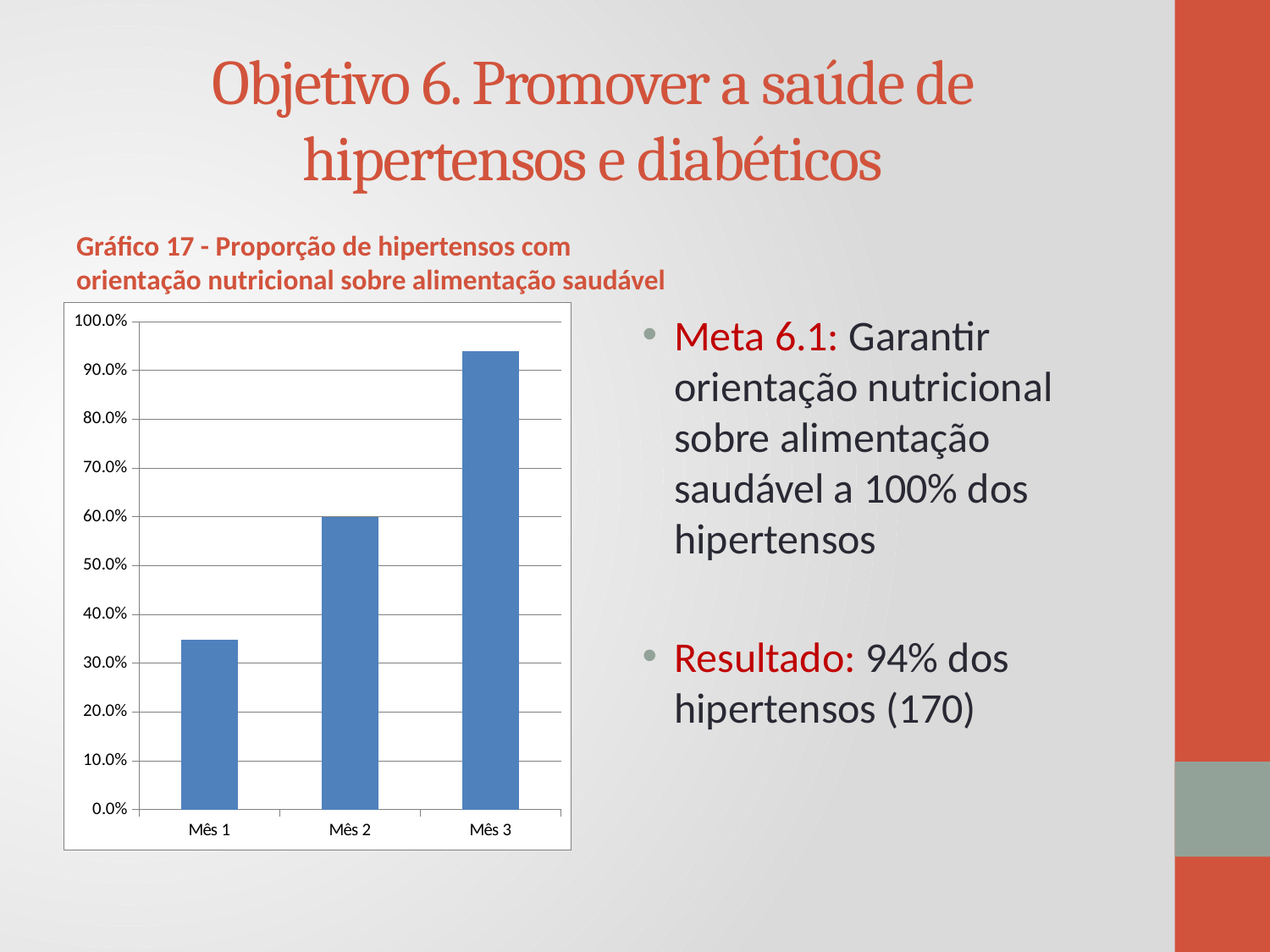
Which month has the highest bar in the chart? Mês 3 Which is larger, the value for Mês 2 or the value for Mês 1? Mês 2 Is the value for Mês 2 greater or less than 70.0%? less How many categories (months) are plotted on the x axis of the chart? 3 Is the value for Mês 1 greater or less than 40.0%? less What is the title of the chart on the slide? Gráfico 17 - Proporção de hipertensos com orientação nutricional sobre alimentação saudável Which is larger, the value for Mês 3 or the value for Mês 2? Mês 3 Which month has the lowest bar in the chart? Mês 1 Do the values rise or fall from Mês 1 to Mês 3? rise What kind of chart is shown on the slide? bar chart Is the value for Mês 3 greater or less than 90.0%? greater